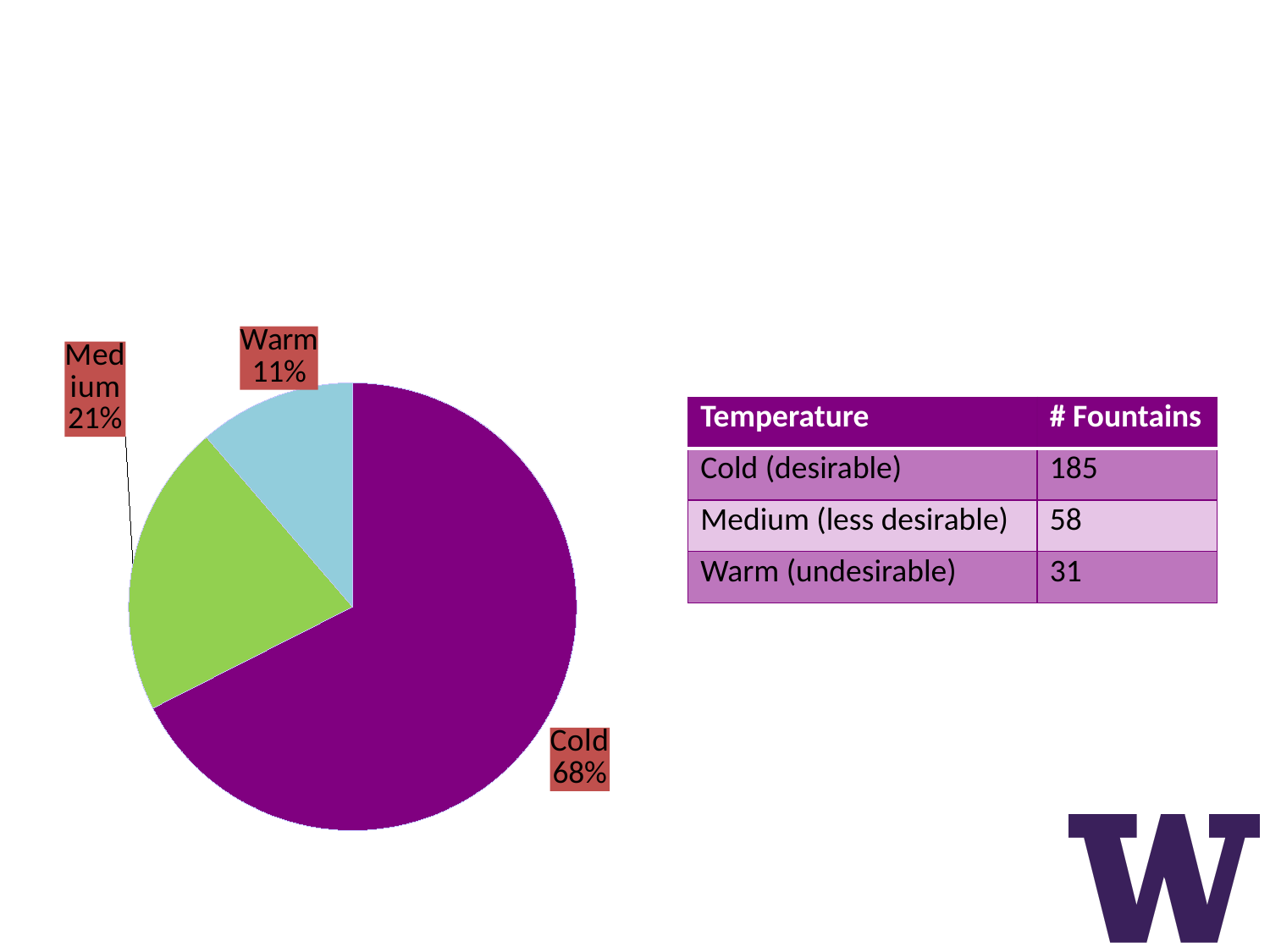
What percentage of the pie does the Cold slice represent? 68% What is the difference in percentage points between the Cold slice and the Medium slice? 47 What is the difference in percentage points between the Medium slice and the Warm slice? 10 What percentage of the pie does the Medium slice represent? 21% How many slices does the pie chart have? 3 What colour is the Cold slice of the pie chart? purple What percentage of the pie does the Warm slice represent? 11% Which slice of the pie chart is the largest? Cold Which slice is larger, Medium or Warm? Medium Which slice of the pie chart is the smallest? Warm What colour is the Warm slice of the pie chart? light blue What kind of chart is shown on the slide? pie chart